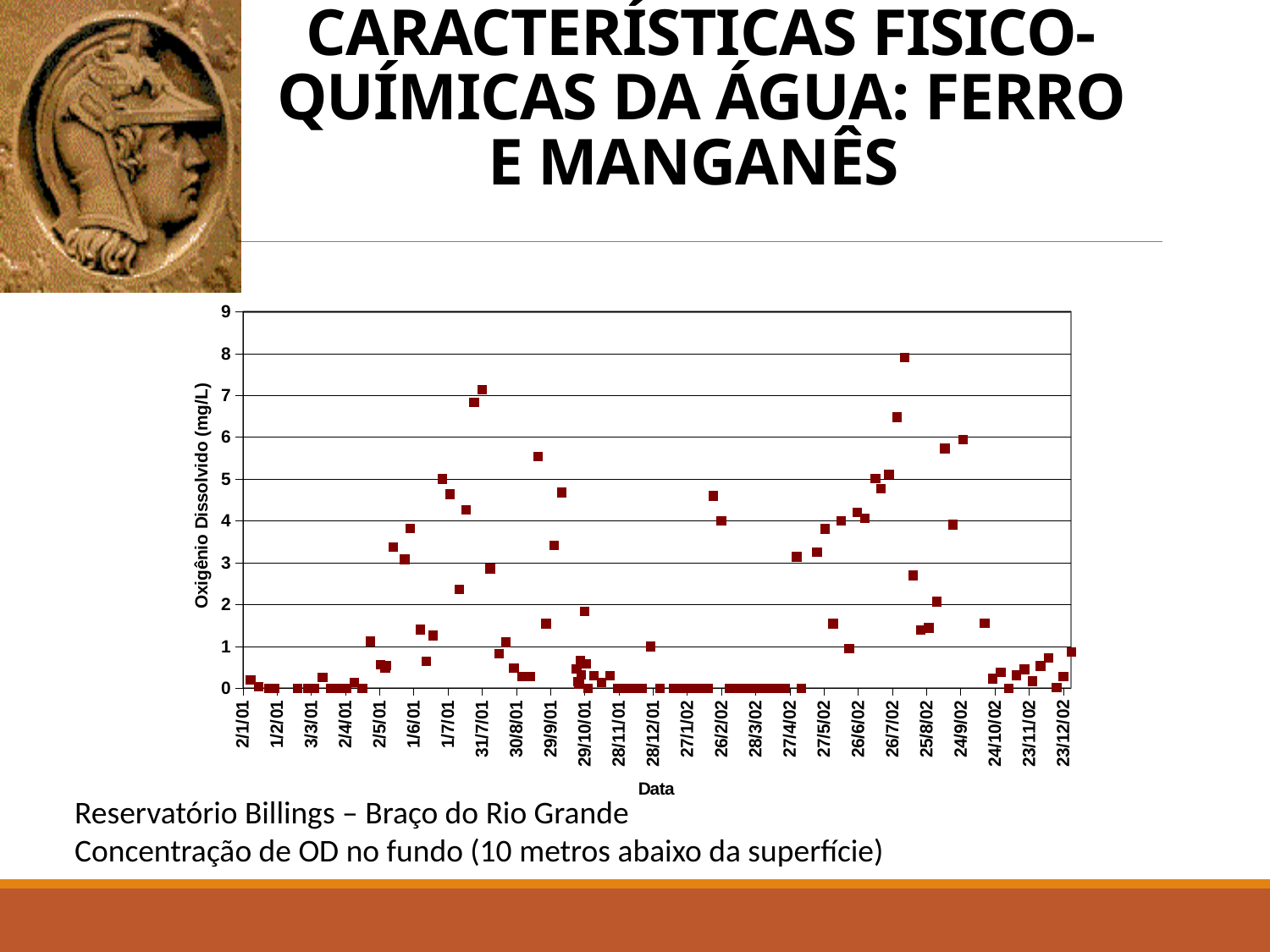
What kind of chart is shown on the slide? scatter chart Do the plotted values generally rise or fall between 2/5/01 and 1/7/01? rise Is the highest plotted value on the chart greater or less than 7? greater Is the highest point plotted near 26/7/02 greater or less than 5? greater Is the highest point plotted near 31/7/01 greater or less than 6? greater What is the label of the vertical axis of the chart? Oxigênio Dissolvido (mg/L) What is the label of the horizontal axis of the chart? Data Do the plotted values generally rise or fall between 27/4/02 and 26/7/02? rise